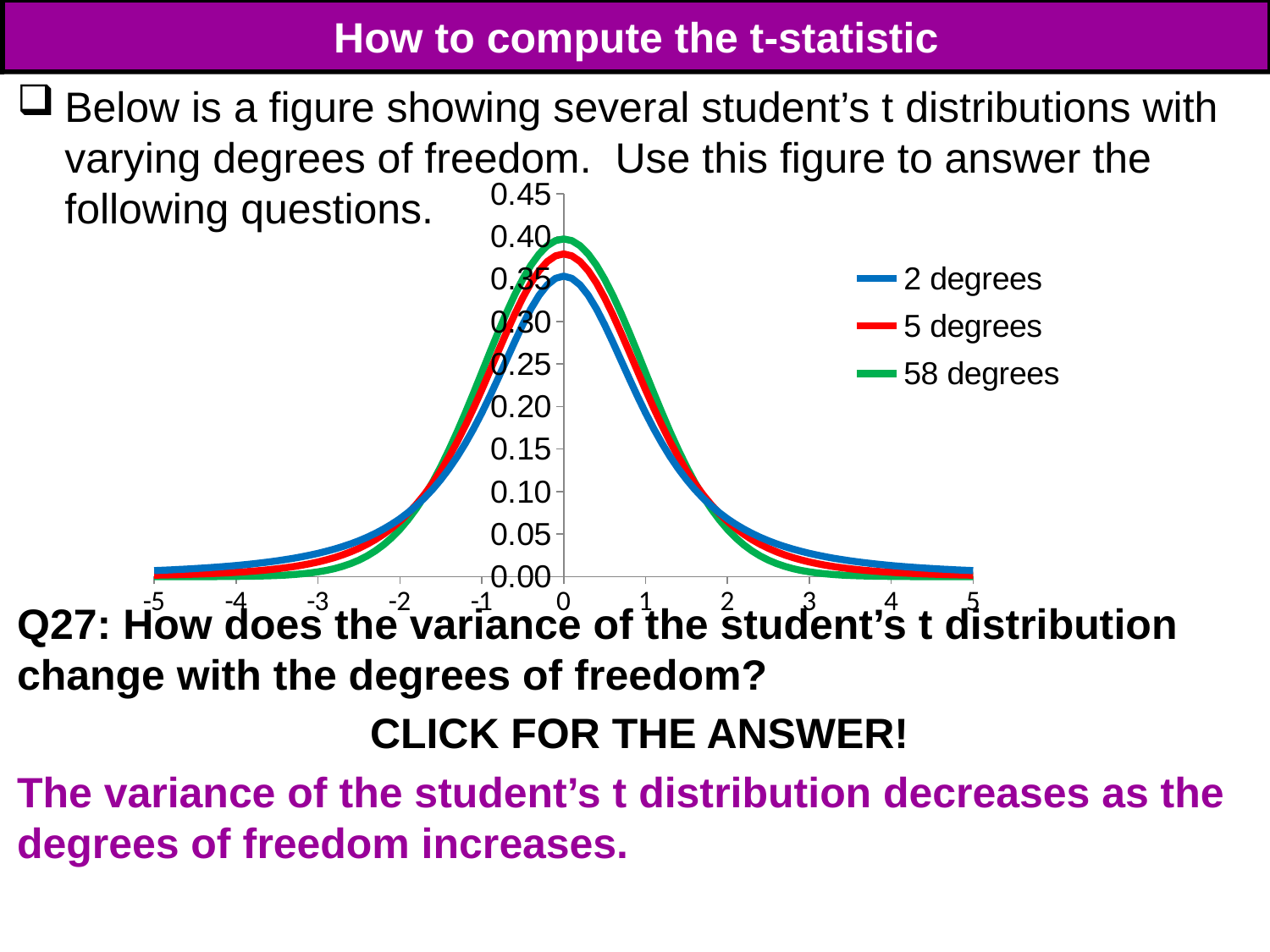
Which series reaches the highest value at x = 0? 58 degrees Do the values of the 58 degrees series rise or fall as x goes from 0 to 5? fall At x = 0, is the value for the 5 degrees series greater or less than 0.30? greater At x = 0, which is larger: the 5 degrees series or the 2 degrees series? 5 degrees At x = 4, which is larger: the 2 degrees series or the 58 degrees series? 2 degrees What is the highest tick label shown on the y axis? 0.45 At x = 0, is the value for the 58 degrees series greater or less than 0.35? greater What kind of chart is shown on the slide? line chart At x = 0, is the value for the 2 degrees series greater or less than 0.40? less Which series has the lowest peak at x = 0? 2 degrees What colour is the line for the 58 degrees series? green How many series does the chart's legend list? 3